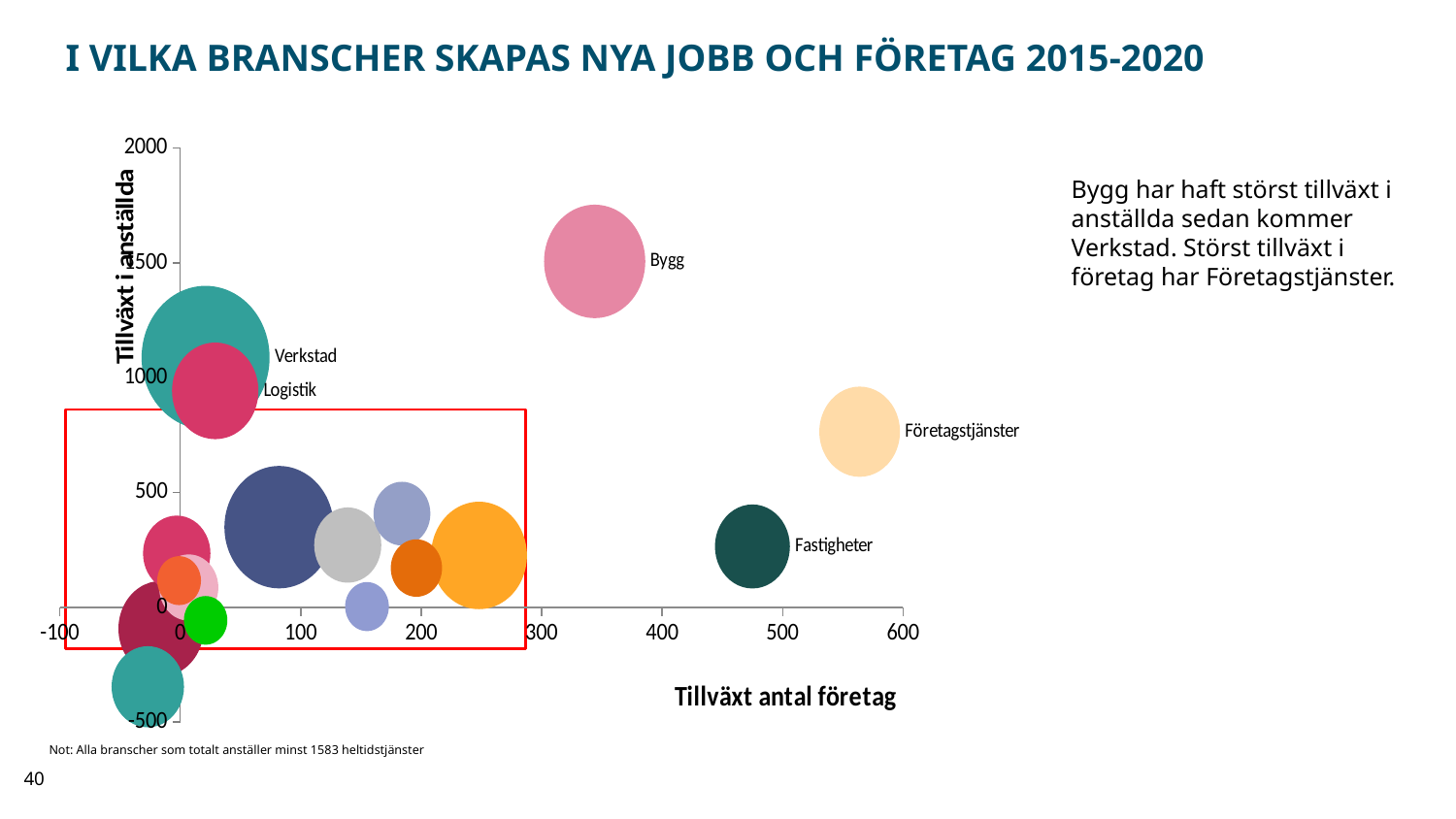
Which is further to the right on the horizontal axis (Tillväxt antal företag), Företagstjänster or Verkstad? Företagstjänster Which has the higher value on the vertical axis (Tillväxt i anställda), Bygg or Fastigheter? Bygg Which labelled industry is furthest to the right on the horizontal axis (Tillväxt antal företag)? Företagstjänster What is the title of the vertical axis? Tillväxt i anställda What kind of chart is shown on the slide? Bubble chart Is the horizontal-axis value (Tillväxt antal företag) for Verkstad greater or less than 100? less Which labelled industry has the highest value on the vertical axis (Tillväxt i anställda)? Bygg Is the horizontal-axis value (Tillväxt antal företag) for Företagstjänster greater or less than 500? greater Is the vertical-axis value (Tillväxt i anställda) for Logistik greater or less than 500? greater What is the title of the horizontal axis? Tillväxt antal företag